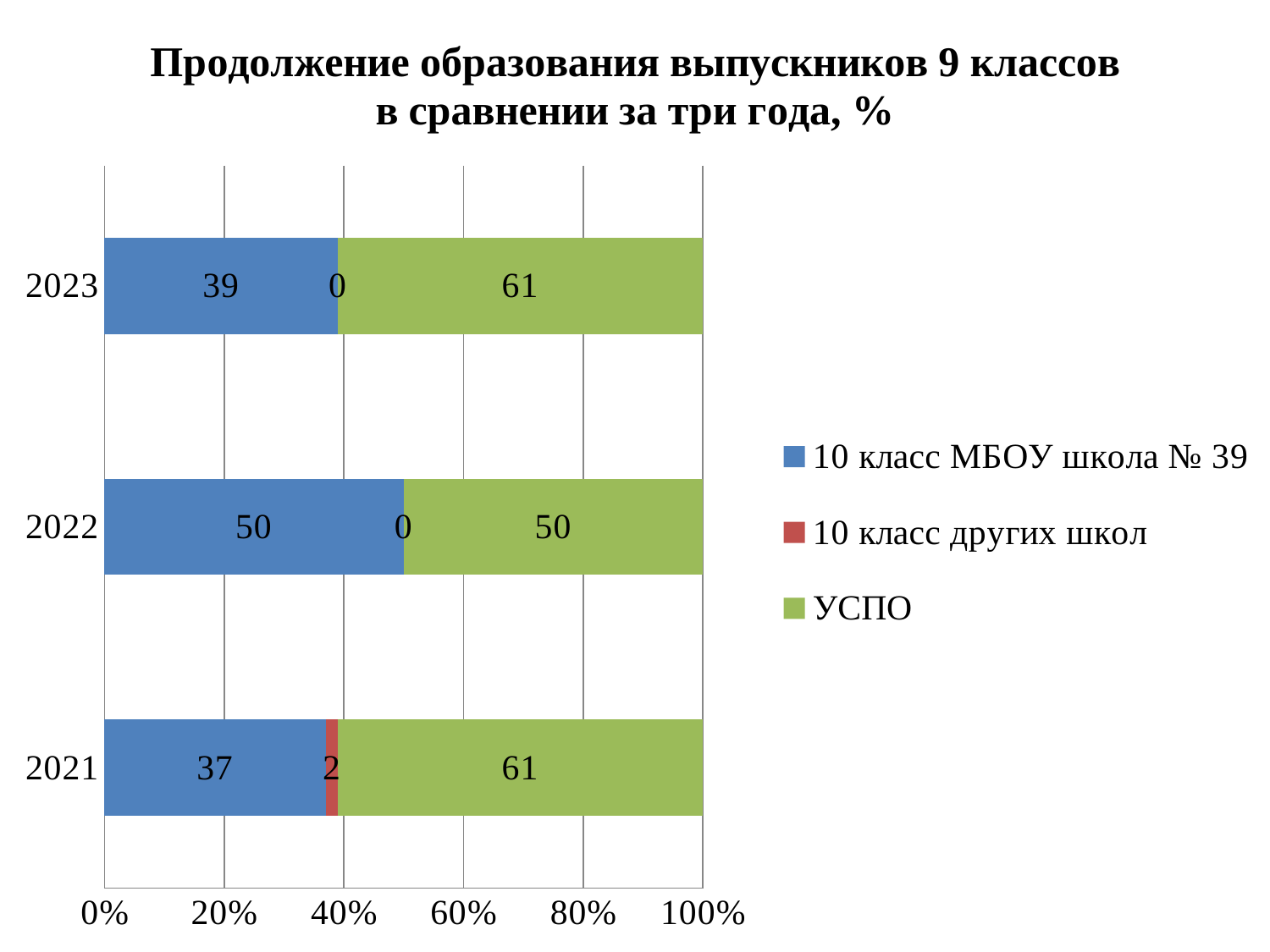
What value is shown for 'УСПО' in 2021? 61 Which is larger in 2023: '10 класс МБОУ школа № 39' or 'УСПО'? УСПО In which year is the value for '10 класс МБОУ школа № 39' highest? 2022 What value is shown for '10 класс других школ' in 2021? 2 What type of chart is shown on the slide? Stacked bar chart In which year is the value for '10 класс МБОУ школа № 39' lowest? 2021 What value is shown for 'УСПО' in 2022? 50 How many series does the legend list? 3 What value is shown for '10 класс МБОУ школа № 39' in 2023? 39 How many years are shown on the chart? 3 What is the total of the stacked bar for 2021? 100 What is the difference between the 'УСПО' values for 2023 and 2022? 11